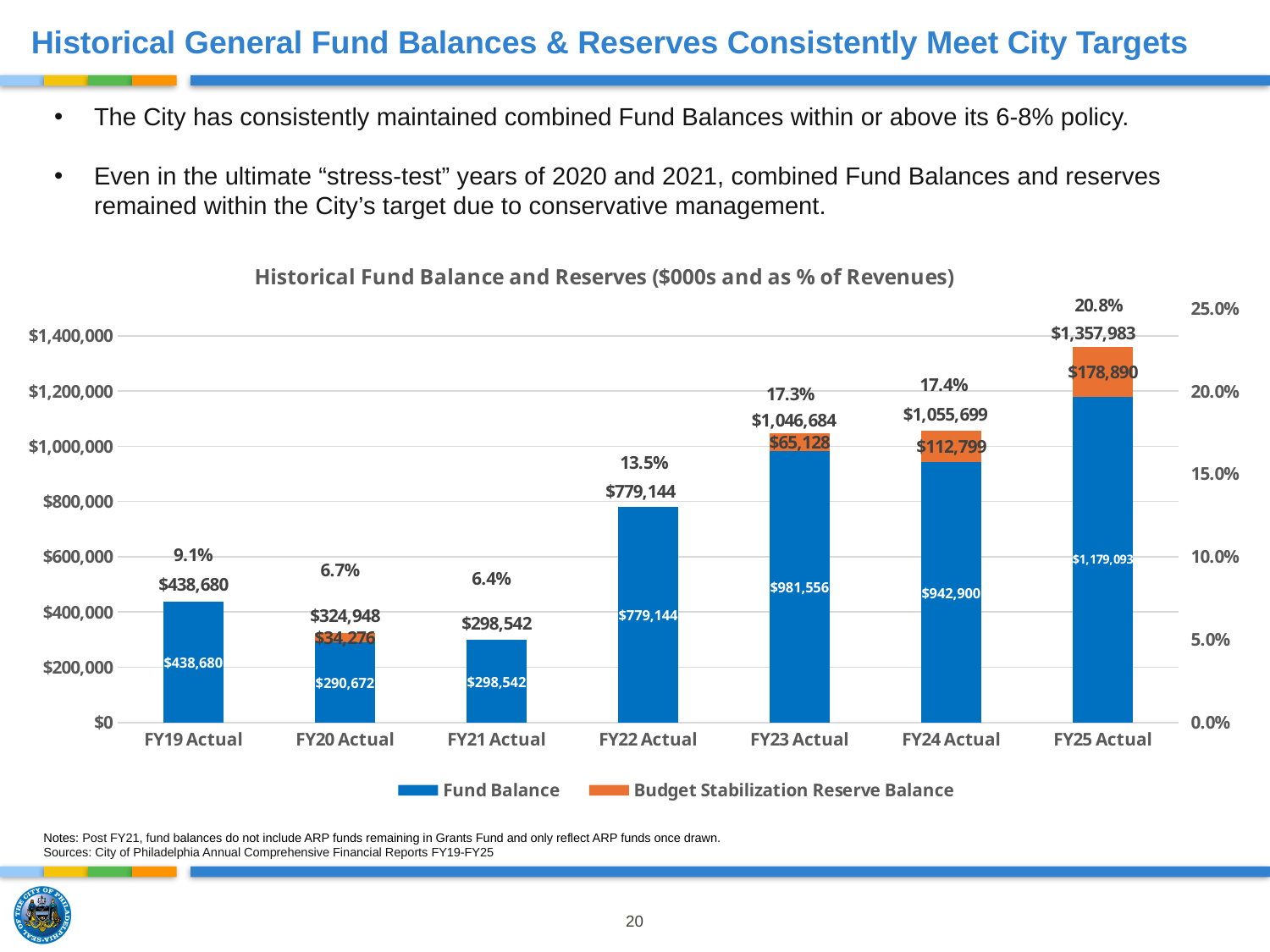
What is the Fund Balance value for FY24 Actual? $942,900 What kind of chart is shown on the slide? Stacked bar chart What is the difference between the Budget Stabilization Reserve Balance in FY24 Actual and FY23 Actual? $47,671 What is the title of the chart? Historical Fund Balance and Reserves ($000s and as % of Revenues) What is the total of the stacked bar for FY23 Actual? $1,046,684 How many series does the legend list? 2 Which fiscal year has the highest combined fund balance and reserves total? FY25 Actual How many fiscal years are shown on the x axis? 7 What is the Budget Stabilization Reserve Balance for FY25 Actual? $178,890 Which fiscal year has the lowest percentage of revenues label? FY21 Actual Which is larger, the Fund Balance for FY23 Actual or for FY24 Actual? FY23 Actual What percentage of revenues is shown above the FY22 Actual bar? 13.5%